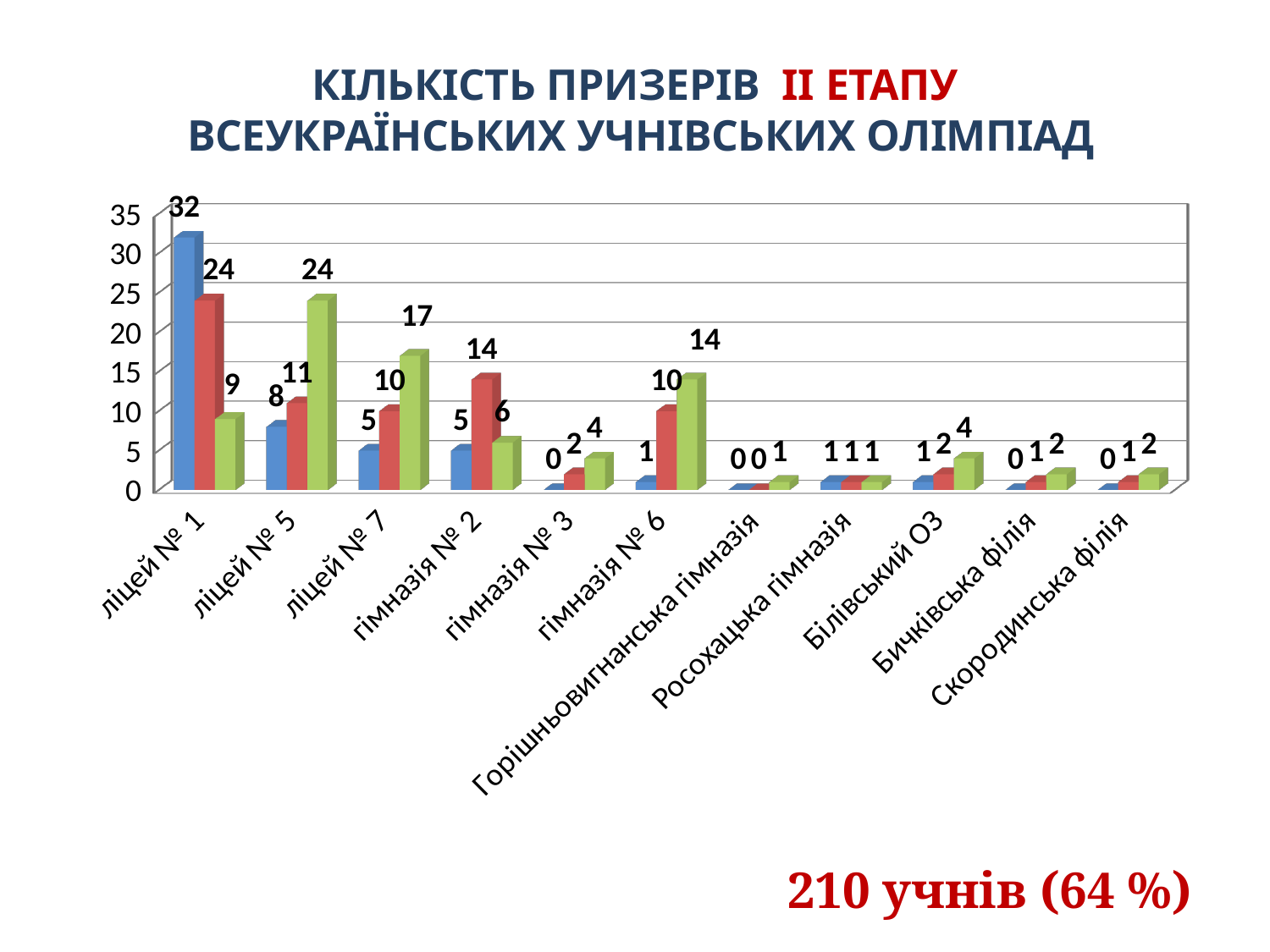
What is the value of the red bar for гімназія № 2? 14 How many categories (schools) are shown on the x axis? 11 What is the value of the blue bar for ліцей № 1? 32 Which is larger: the red bar for ліцей № 5 or the red bar for ліцей № 7? ліцей № 5 What is the total of the three bars for Росохацька гімназія? 3 What is the value of the green bar for ліцей № 5? 24 What is the difference between the green bar for ліцей № 7 and the green bar for ліцей № 5? 7 What type of chart is shown on the slide? bar chart Which school has the highest blue bar? ліцей № 1 What is the difference between the blue bar and the red bar for ліцей № 1? 8 What total number of students and percentage is printed in red at the bottom of the slide? 210 учнів (64 %) What is the value of the green bar for гімназія № 6? 14